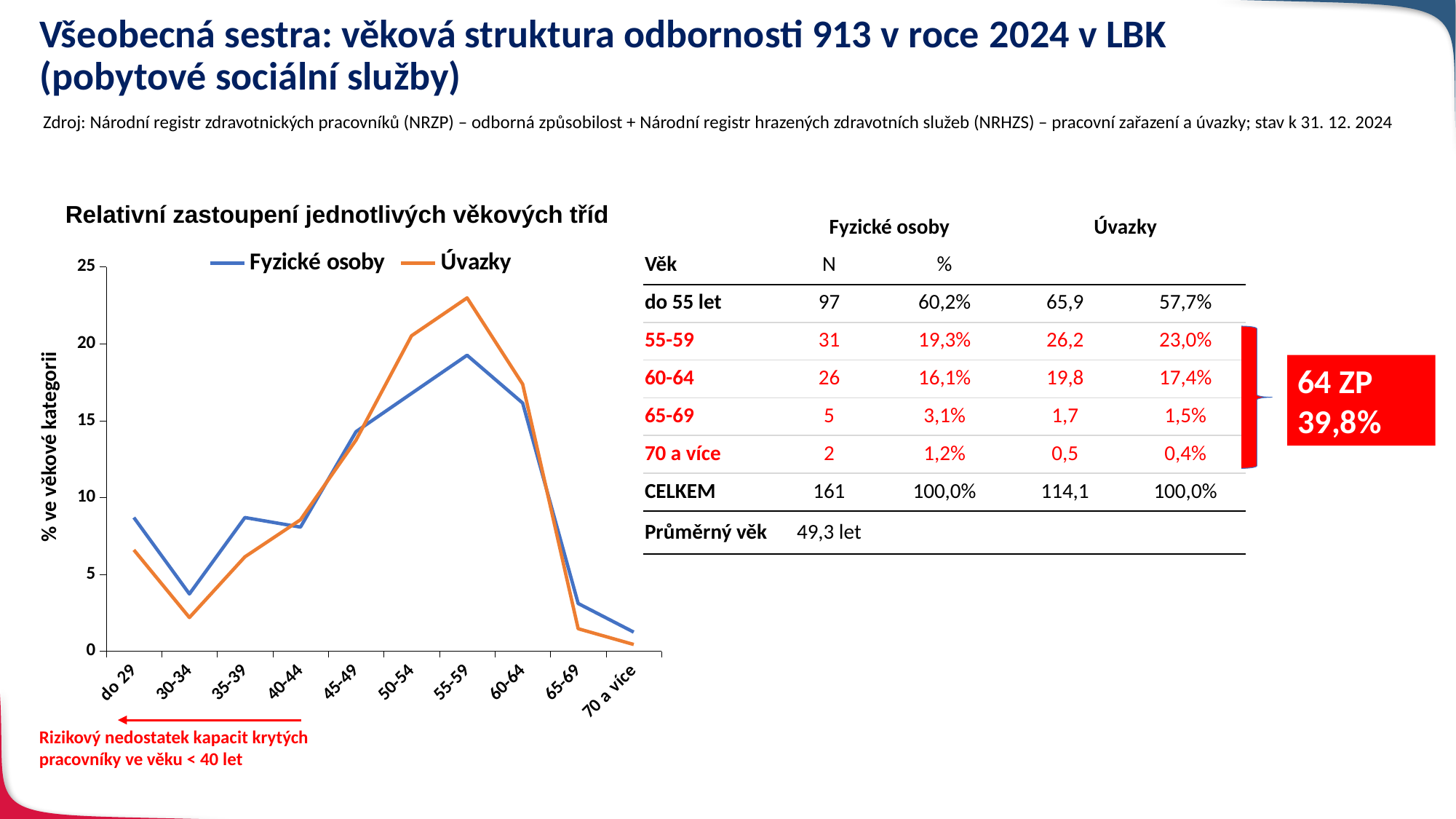
Is the value of Fyzické osoby for do 29 greater or less than 5? greater How many series does the chart legend list? 2 In which age category is the Úvazky series lowest? 70 a více At 55-59, which series has the larger value, Fyzické osoby or Úvazky? Úvazky Is the value of Úvazky for 55-59 greater or less than 20? greater How many age categories are shown on the x axis of the chart? 10 Is the value of Úvazky for 30-34 greater or less than 5? less At do 29, which series has the larger value, Fyzické osoby or Úvazky? Fyzické osoby In which age category does the Úvazky series reach its highest value? 55-59 What kind of chart is shown on the slide? line chart Do the values of both series rise or fall from 55-59 to 70 a více? fall In which age category does the Fyzické osoby series reach its highest value? 55-59